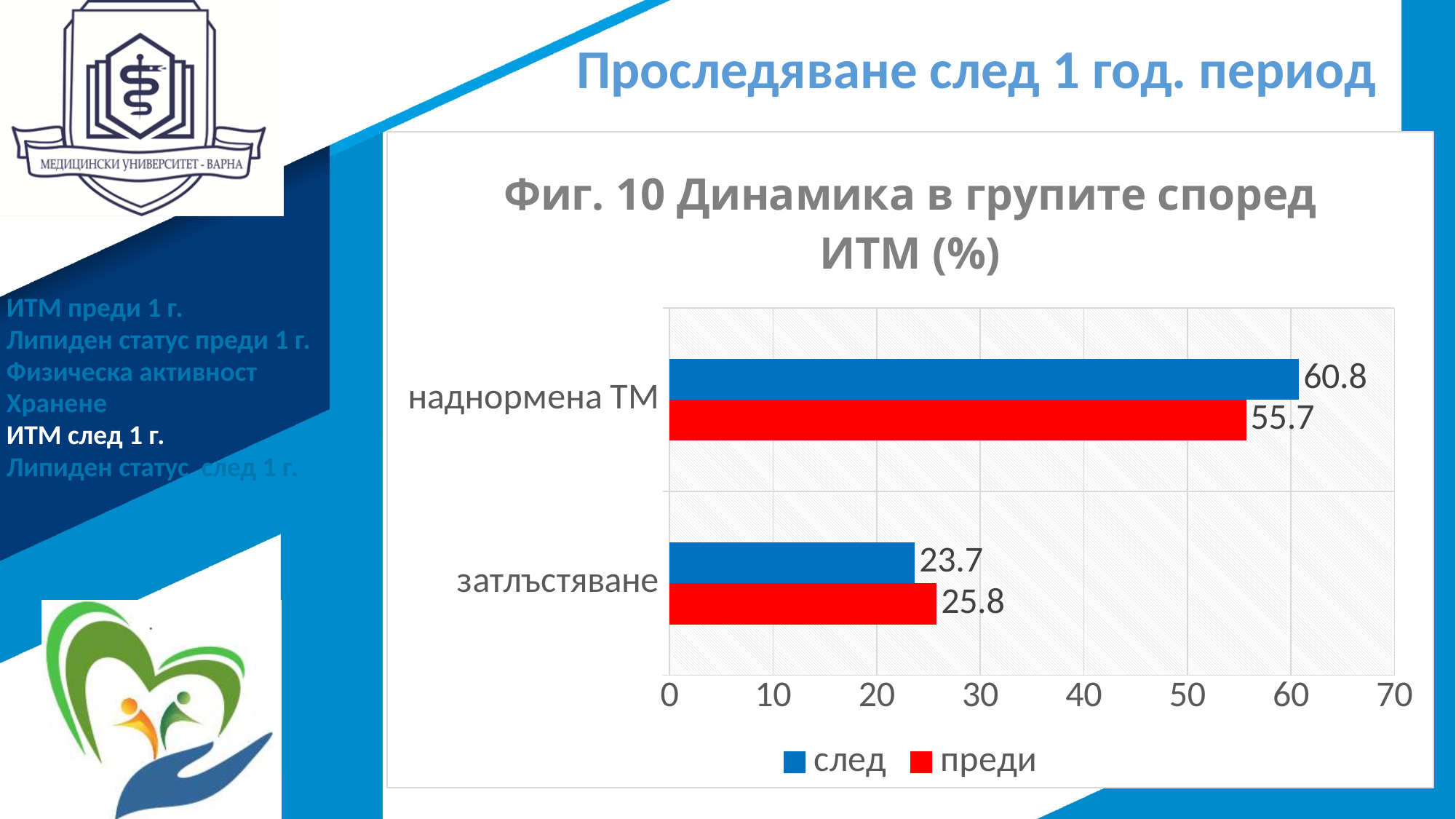
Which category has the highest value for the "след" series? наднормена ТМ What colour represents the "преди" series in the chart? red What is the value for "преди" in the "наднормена ТМ" category? 55.7 How many categories are shown on the chart? 2 What kind of chart is shown on the slide? bar chart How many series does the legend list? 2 What is the difference between the "след" and "преди" values for "наднормена ТМ"? 5.1 What is the value for "след" in the "затлъстяване" category? 23.7 What is the value for "преди" in the "затлъстяване" category? 25.8 Which category has the lowest value for the "преди" series? затлъстяване For "затлъстяване", which is larger: the "след" value or the "преди" value? преди What is the value for "след" in the "наднормена ТМ" category? 60.8